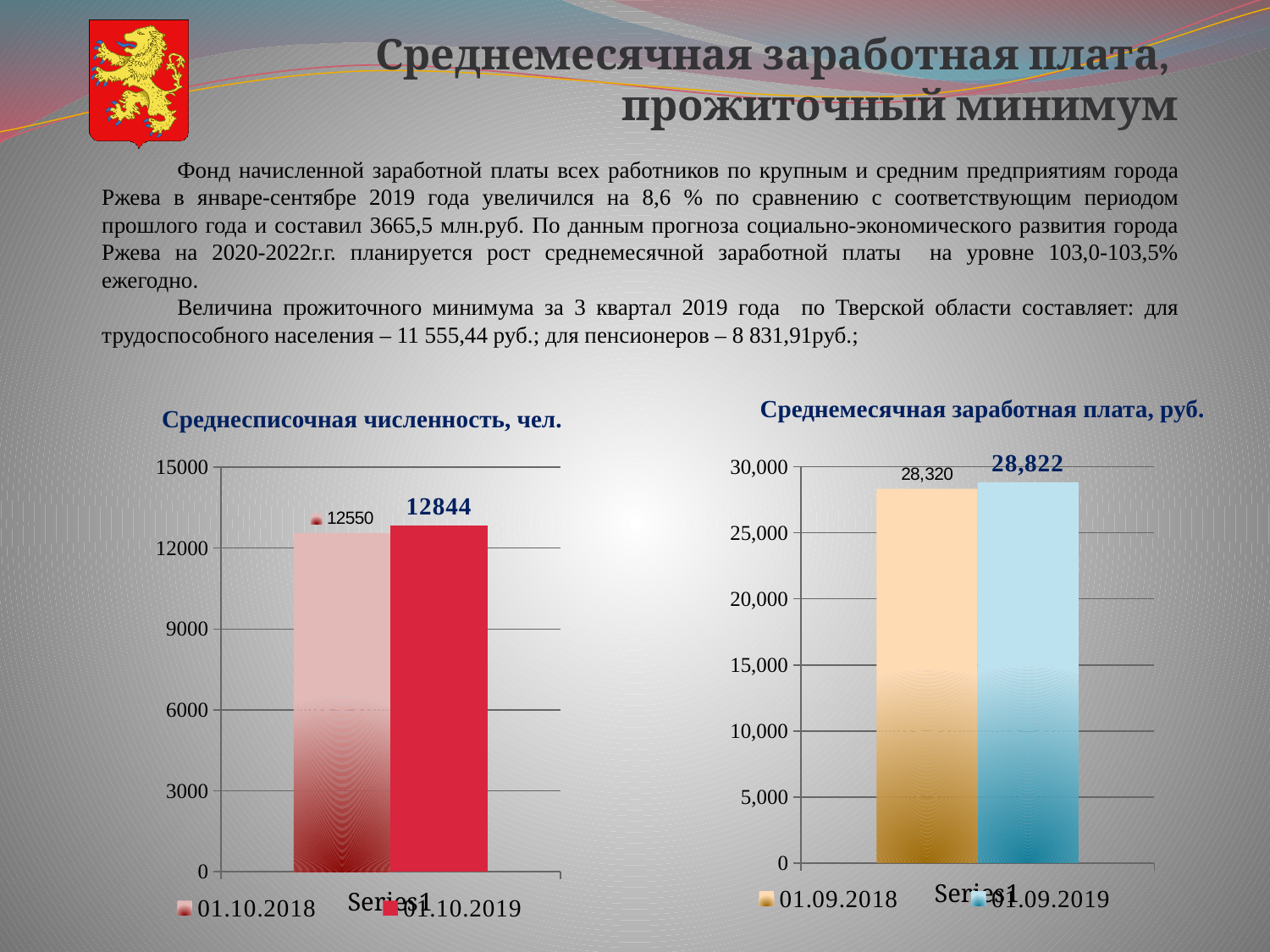
On the chart titled "Среднемесячная заработная плата, руб.", what is the difference between the 01.09.2019 and 01.09.2018 values? 502 On the chart titled "Среднемесячная заработная плата, руб.", which series has the lower value? 01.09.2018 On the chart titled "Среднемесячная заработная плата, руб.", how many series does the legend list? 2 On the chart titled "Среднесписочная численность, чел.", which series has the higher value, 01.10.2018 or 01.10.2019? 01.10.2019 What kind of chart is the one titled "Среднесписочная численность, чел."? bar chart On the chart titled "Среднесписочная численность, чел.", is the value for 01.10.2018 greater or less than 12000? greater On the chart titled "Среднемесячная заработная плата, руб.", what is the highest value shown on the vertical axis? 30,000 On the chart titled "Среднесписочная численность, чел.", what is the value for 01.10.2019? 12844 On the chart titled "Среднесписочная численность, чел.", what is the value for 01.10.2018? 12550 On the chart titled "Среднемесячная заработная плата, руб.", what is the value for 01.09.2019? 28,822 On the chart titled "Среднемесячная заработная плата, руб.", what is the value for 01.09.2018? 28,320 On the chart titled "Среднесписочная численность, чел.", what is the difference between the 01.10.2019 and 01.10.2018 values? 294